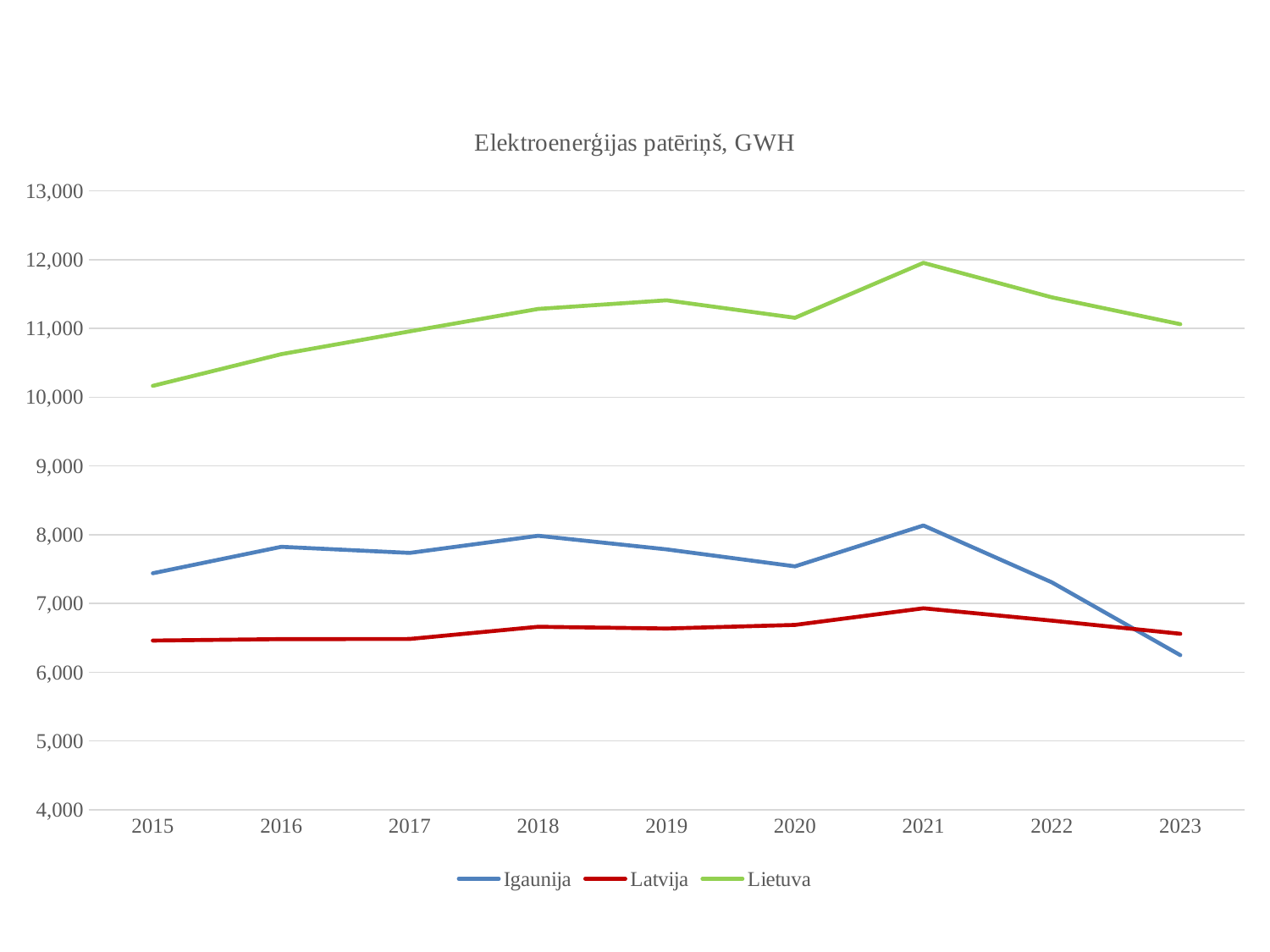
In 2023, which is larger: the value for Igaunija or the value for Latvija? Latvija What kind of chart is shown on the slide? line chart How many series does the legend list? 3 Is the value for Lietuva in 2021 greater or less than 11,000? greater Does the Igaunija line rise or fall from 2021 to 2023? fall How many years are plotted along the x axis? 9 What is the title of the chart? Elektroenerģijas patēriņš, GWH Which country has the highest electricity consumption across all years shown? Lietuva In which year does the Lietuva line reach its highest value? 2021 In which year does the Igaunija line reach its highest value? 2021 Is the value for Igaunija in 2023 greater or less than 7,000? less Is the value for Latvija in 2015 greater or less than 7,000? less